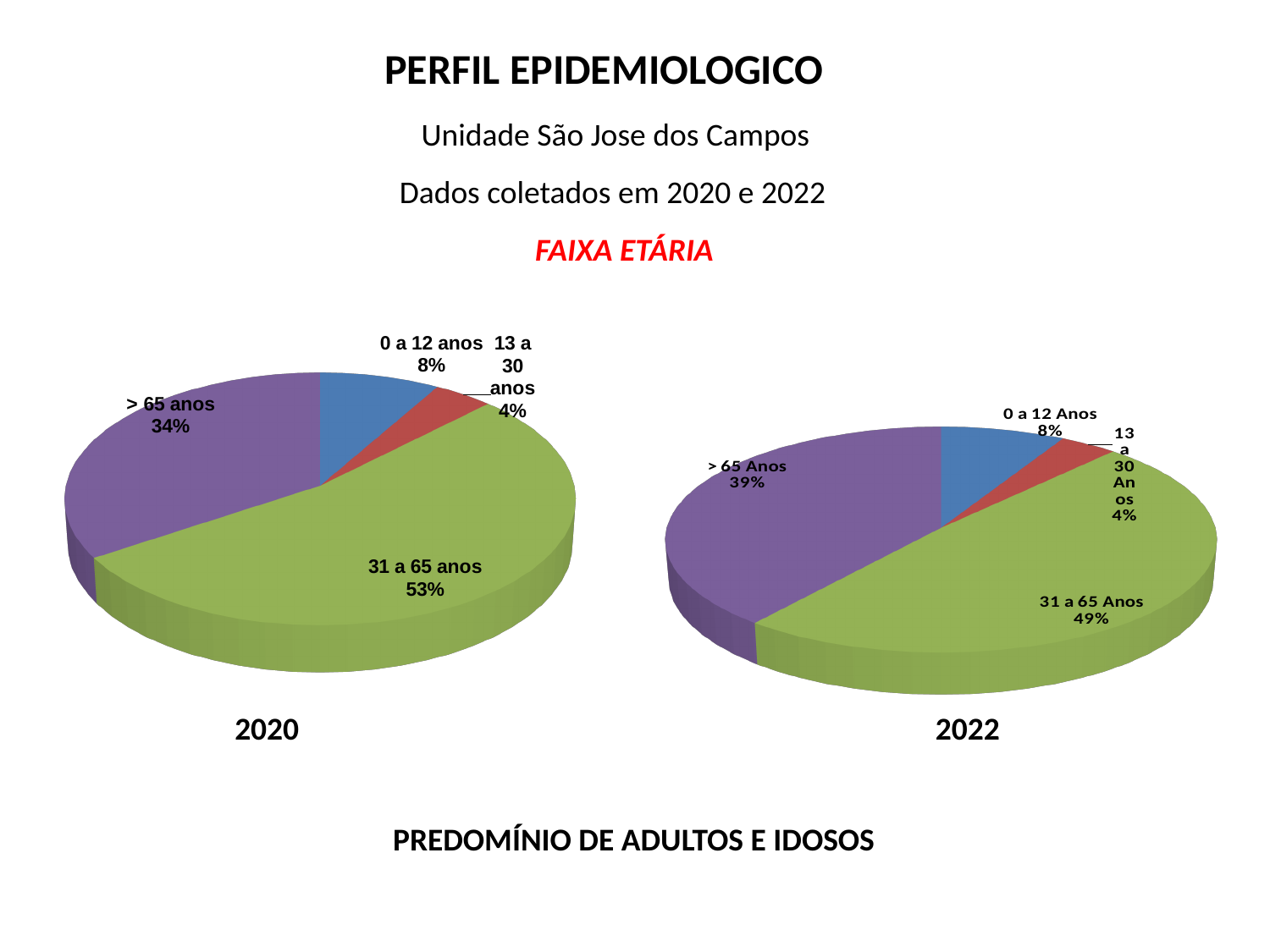
How many slices does the 2020 pie chart have? 4 In the 2022 pie chart, what share is labelled for > 65 Anos? 39% In the 2020 pie chart, which age group has the largest slice? 31 a 65 anos In the 2022 pie chart, which is larger: the share for 0 a 12 Anos or the share for 13 a 30 Anos? 0 a 12 Anos In the 2022 pie chart, what share is labelled for 31 a 65 Anos? 49% In the 2020 pie chart, what share is labelled for 0 a 12 anos? 8% In the 2022 pie chart, which age group has the smallest slice? 13 a 30 Anos In the 2020 pie chart, what is the difference between the shares for 31 a 65 anos and > 65 anos? 19% What kind of chart is used for the 2022 data? Pie chart